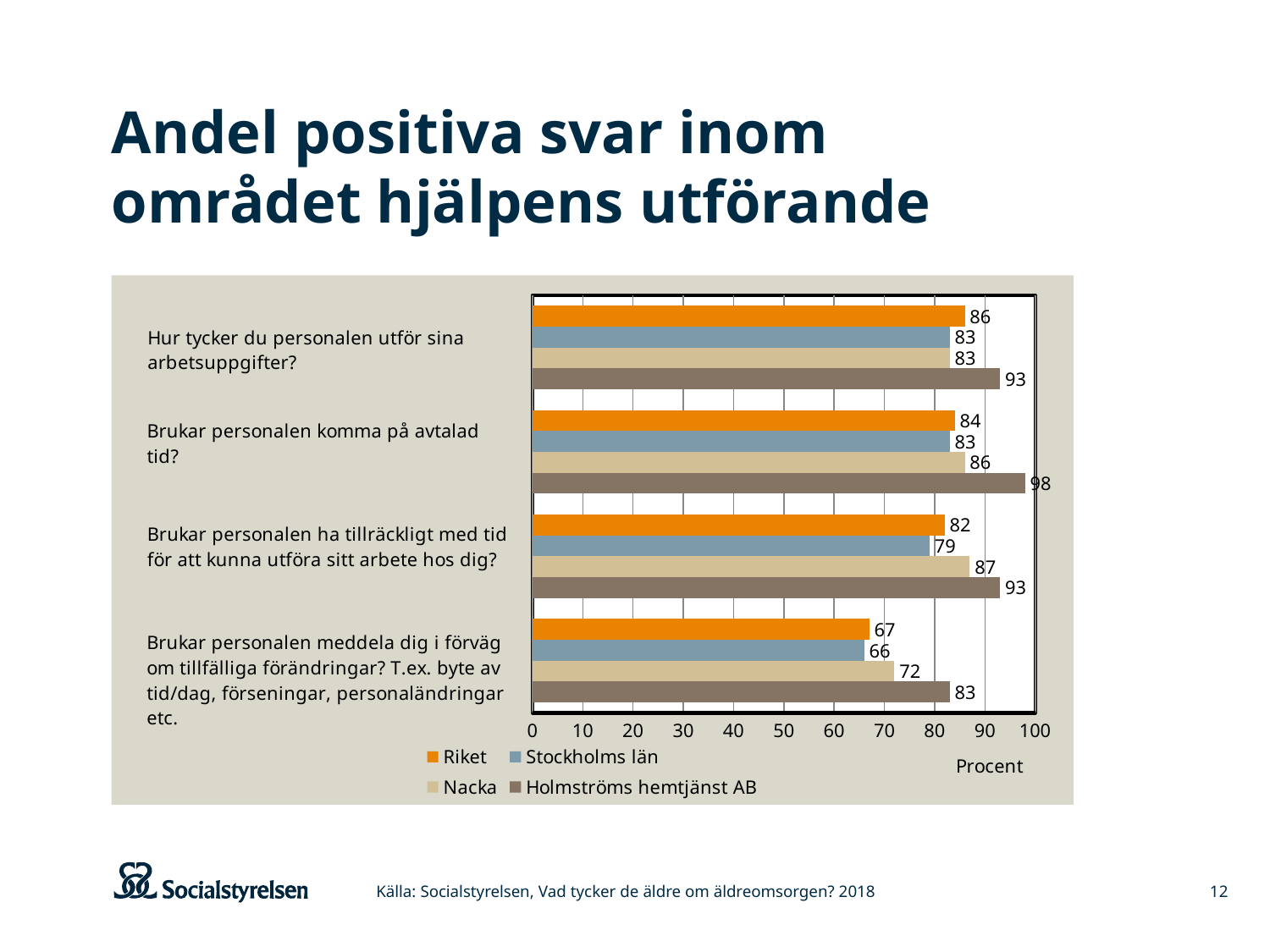
What is the value for Riket for "Brukar personalen meddela dig i förväg om tillfälliga förändringar?" 67 How many series does the legend list? 4 What is the value for Stockholms län for "Hur tycker du personalen utför sina arbetsuppgifter?" 83 What kind of chart is shown on the slide? bar chart What is the value for Holmströms hemtjänst AB for "Brukar personalen komma på avtalad tid?" 98 Which is larger for "Brukar personalen ha tillräckligt med tid för att kunna utföra sitt arbete hos dig?": Riket or Stockholms län? Riket What is the label on the horizontal axis of the chart? Procent Which series has the lowest value for "Brukar personalen meddela dig i förväg om tillfälliga förändringar?" Stockholms län What is the value for Nacka for "Brukar personalen ha tillräckligt med tid för att kunna utföra sitt arbete hos dig?" 87 How many question categories are plotted on the chart? 4 Which series has the highest value for "Brukar personalen komma på avtalad tid?" Holmströms hemtjänst AB What is the difference between Holmströms hemtjänst AB and Riket for "Brukar personalen meddela dig i förväg om tillfälliga förändringar?" 16